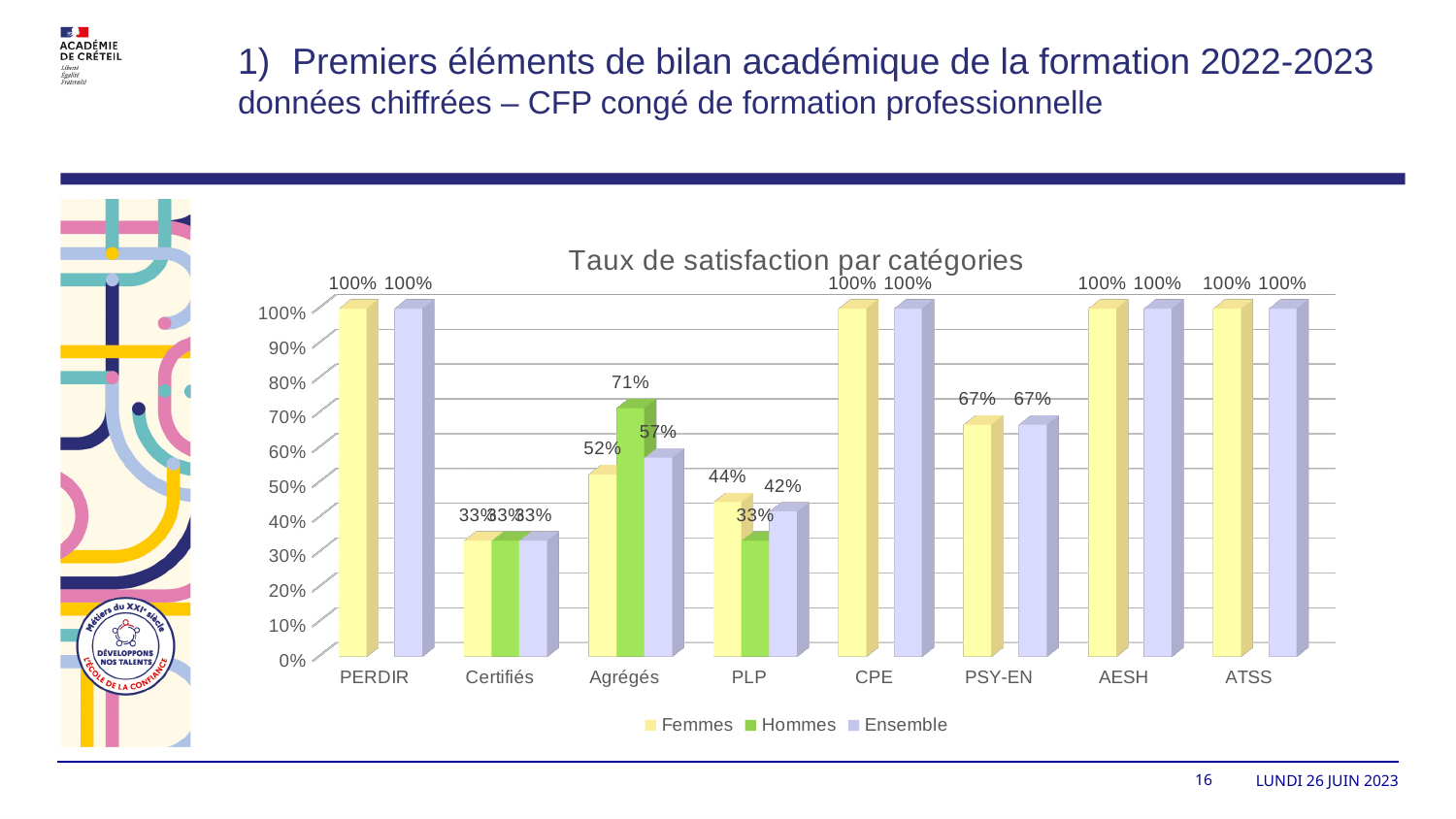
Which category has the lowest Femmes satisfaction rate? Certifiés What is the Hommes satisfaction rate for Agrégés? 71% Which is larger: the Femmes rate for Agrégés or the Femmes rate for PLP? Agrégés What type of chart is shown on the slide? Bar chart For Agrégés, how much higher is the Hommes rate than the Femmes rate? 19 percentage points What is the Ensemble satisfaction rate for PSY-EN? 67% What is the Femmes satisfaction rate for PLP? 44% What is the Ensemble satisfaction rate for PLP? 42% How many series does the legend list? 3 How many categories are shown on the x axis? 8 Which category has the highest Hommes satisfaction rate? Agrégés What is the Ensemble satisfaction rate for Agrégés? 57%